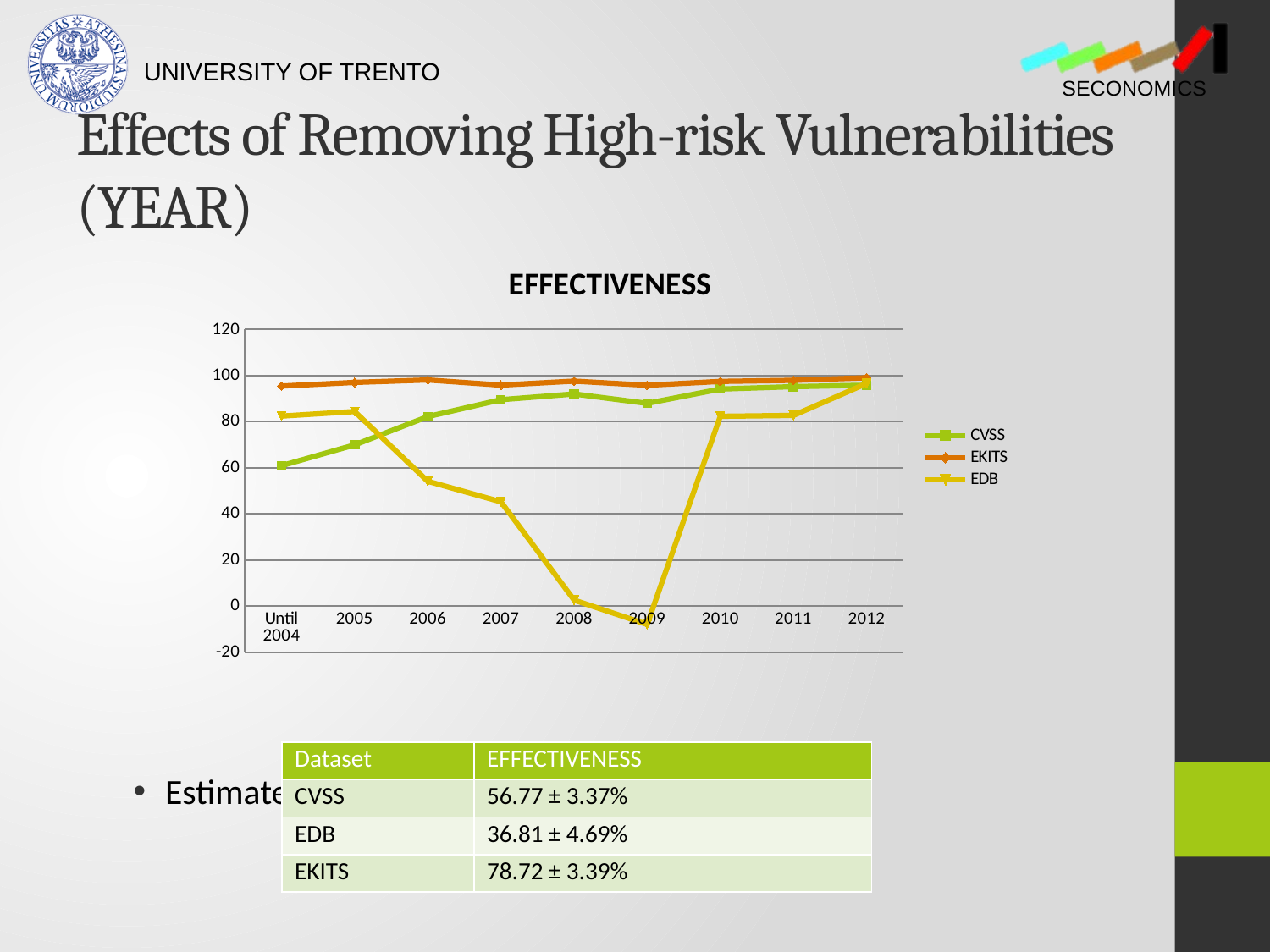
At which x-axis point does the EDB series reach its lowest value? 2009 What kind of chart is shown under the title EFFECTIVENESS? line chart Is the value of EDB at 2008 greater or less than 20? less Which series in the EFFECTIVENESS chart has the lowest value at 2009? EDB At 2008, which series has the larger value, CVSS or EDB? CVSS How many points along the x axis does the EFFECTIVENESS chart have? 9 How many series does the legend of the EFFECTIVENESS chart list? 3 Does the CVSS series rise or fall from Until 2004 to 2012? rise Is the value of EDB at 2009 greater or less than 0? less Is the value of EKITS at 2005 greater or less than 80? greater Which series in the EFFECTIVENESS chart is drawn in yellow? EDB